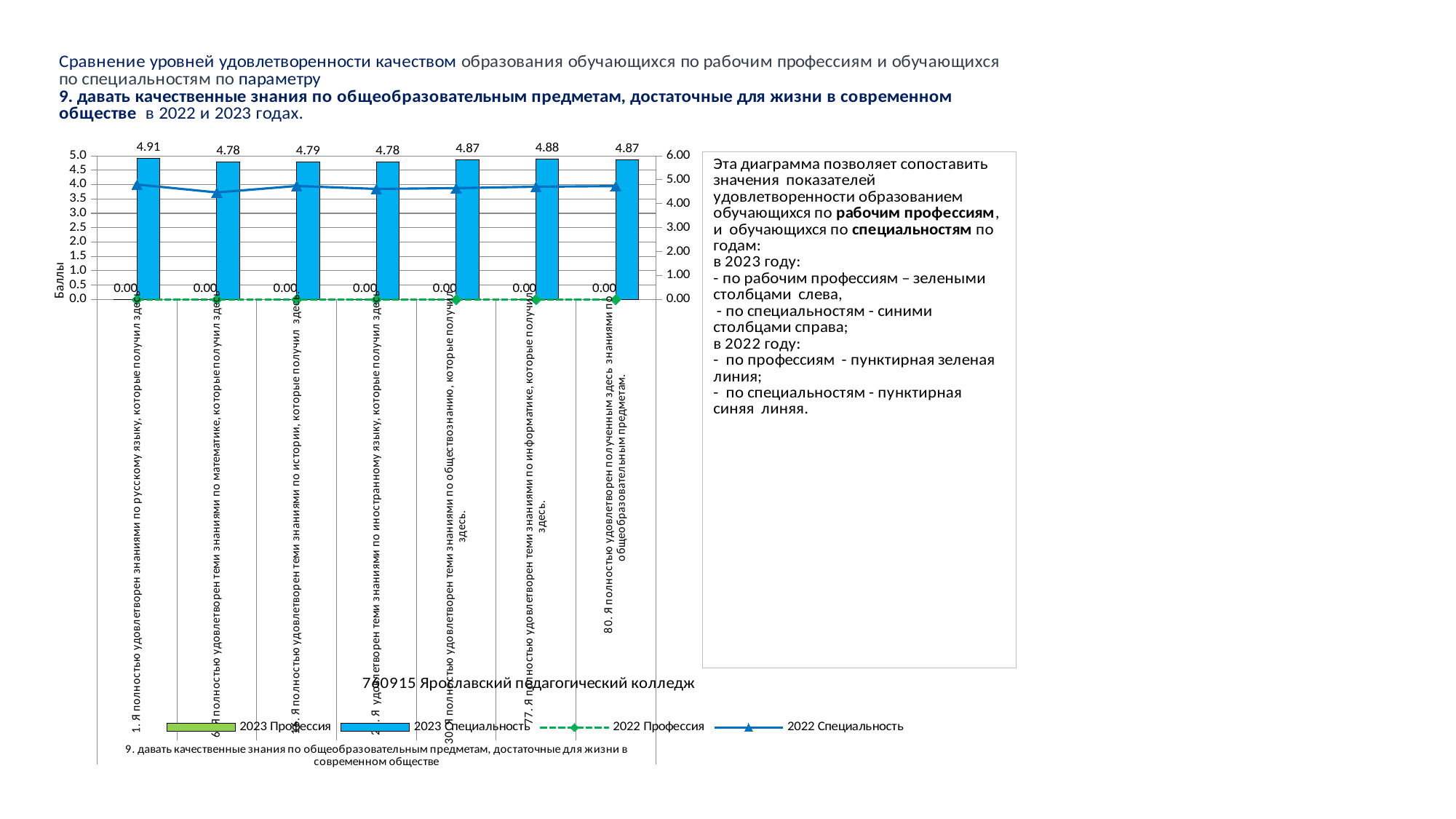
According to the legend, how is the 2022 Профессия series drawn? green dashed line Which category has the highest 2023 Специальность value? 1. Я полностью удовлетворен знаниями по русскому языку, которые получил здесь Which has the larger 2023 Специальность value: the category about истории or the category about обществознанию? обществознанию What is the 2023 Специальность value for the category about информатике (item 77)? 4.88 What is the 2023 Специальность value for the category about русскому языку (item 1)? 4.91 What is the difference between the 2023 Специальность values for русскому языку (4.91) and математике (4.78)? 0.13 What is the 2023 Профессия value for the category about русскому языку (item 1)? 0.00 How many series does the legend list? 4 What kind of chart is shown on the slide? bar and line chart What is the 2023 Специальность value for the category about математике? 4.78 How many categories are plotted on the chart? 7 What is the lowest 2023 Специальность value shown on the chart? 4.78